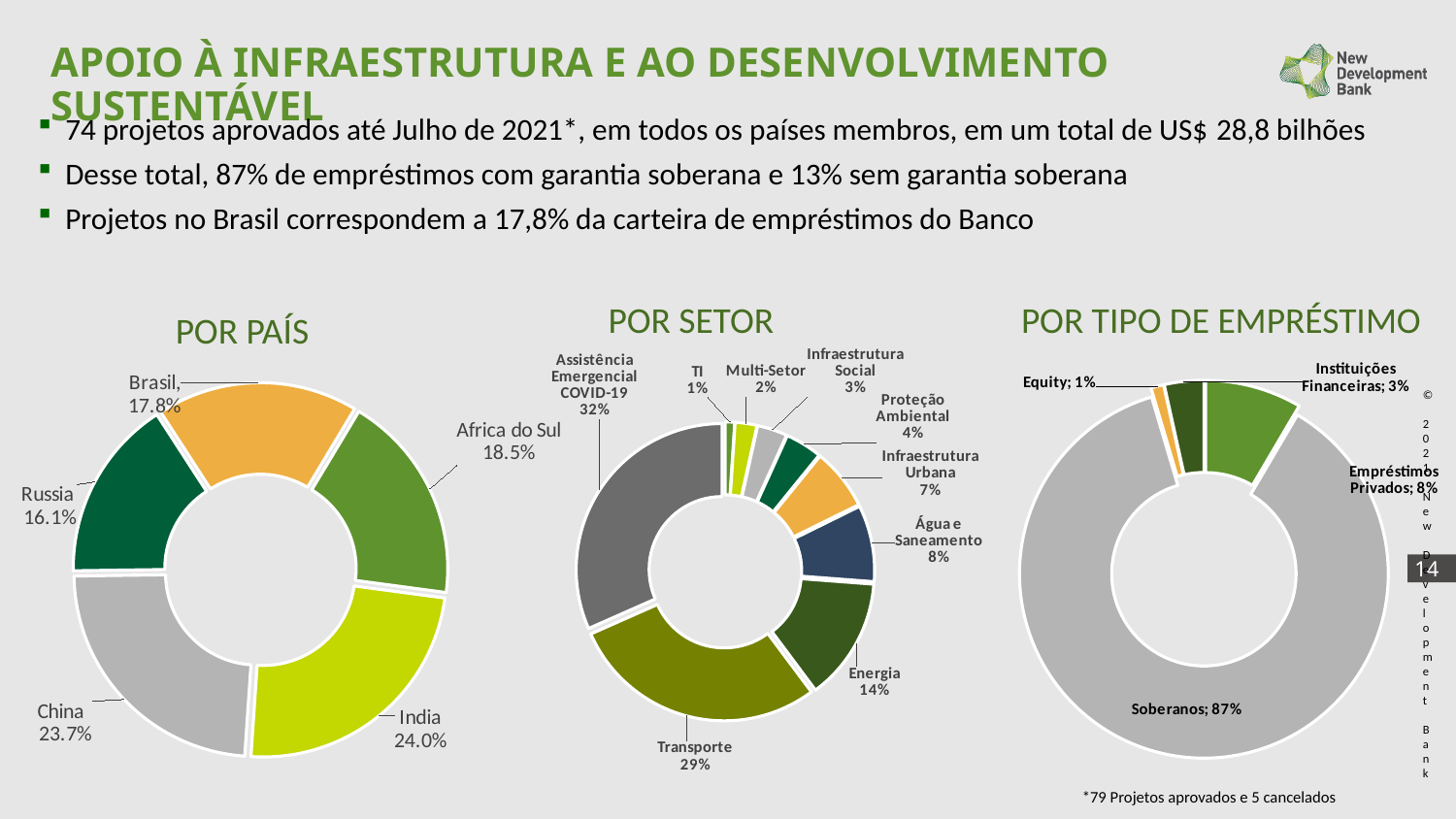
How many countries are shown in the POR PAÍS chart? 5 In the POR TIPO DE EMPRÉSTIMO chart, what is the difference between Empréstimos Privados and Instituições Financeiras? 5% In the POR PAÍS chart, what is the difference between the shares of India and Russia? 7.9% In the POR SETOR chart, which is larger: Energia or Água e Saneamento? Energia In the POR PAÍS chart, which country has the largest share? India In the POR SETOR chart, what share does Transporte have? 29% How many sectors are shown in the POR SETOR chart? 9 In the POR PAÍS chart, what share does Brasil have? 17.8% What type of chart is the POR SETOR chart? Doughnut chart In the POR SETOR chart, which sector has the largest share? Assistência Emergencial COVID-19 In the POR PAÍS chart, which country has the smallest share? Russia In the POR TIPO DE EMPRÉSTIMO chart, what share do Soberanos have? 87%